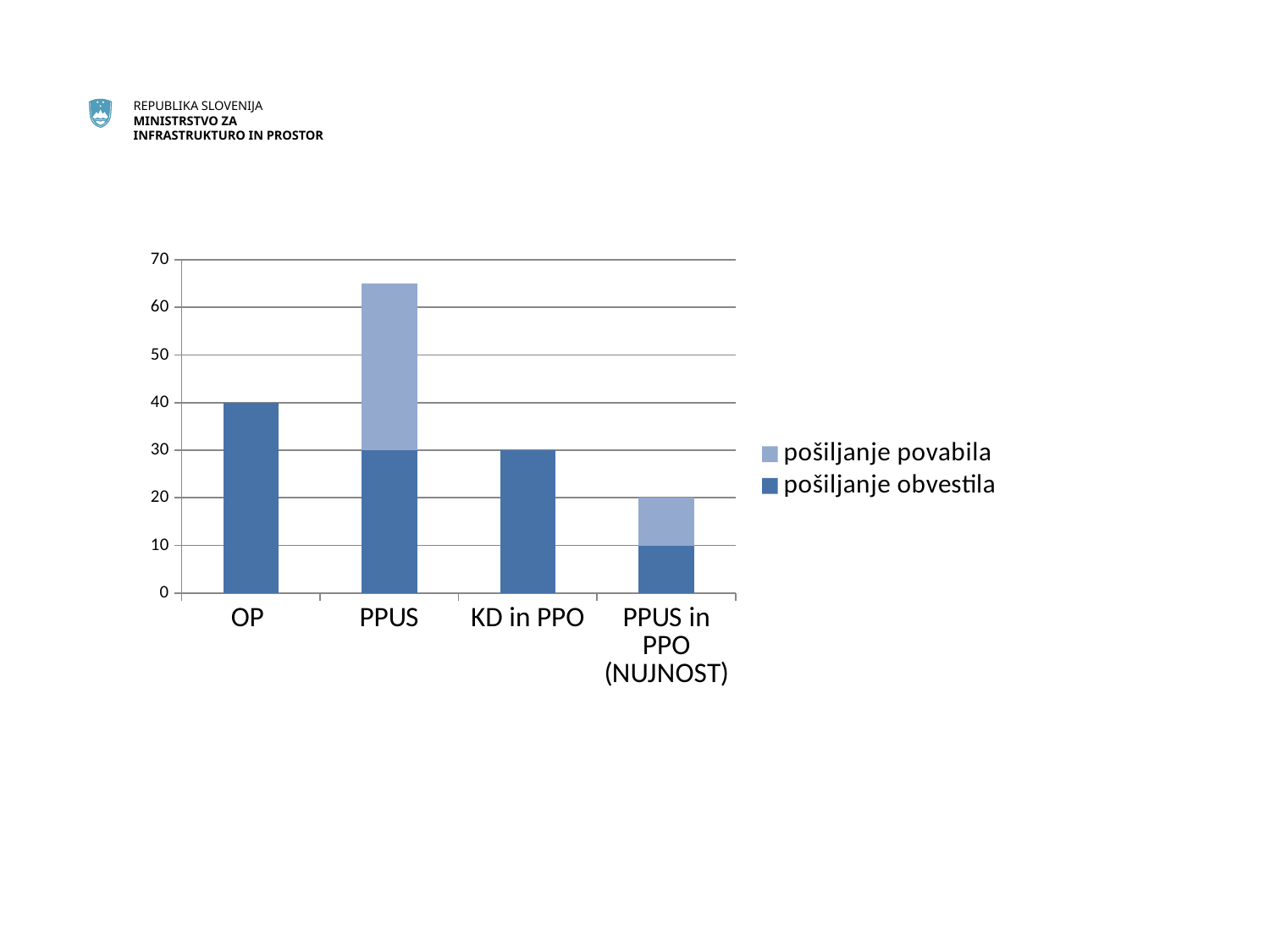
What is the value of pošiljanje obvestila for PPUS? 30 Which category has the tallest stacked bar overall? PPUS Which series is shown in the lighter blue colour? pošiljanje povabila What is the value of pošiljanje obvestila for PPUS in PPO (NUJNOST)? 10 How many categories are shown on the x axis? 4 What kind of chart is shown on the slide? bar chart Is the total height of the PPUS bar greater or less than 60? greater Which has the larger pošiljanje obvestila value, OP or KD in PPO? OP What is the value of pošiljanje obvestila for OP? 40 How many series does the legend list? 2 Which category has the shortest stacked bar overall? PPUS in PPO (NUJNOST) What is the value of pošiljanje obvestila for KD in PPO? 30